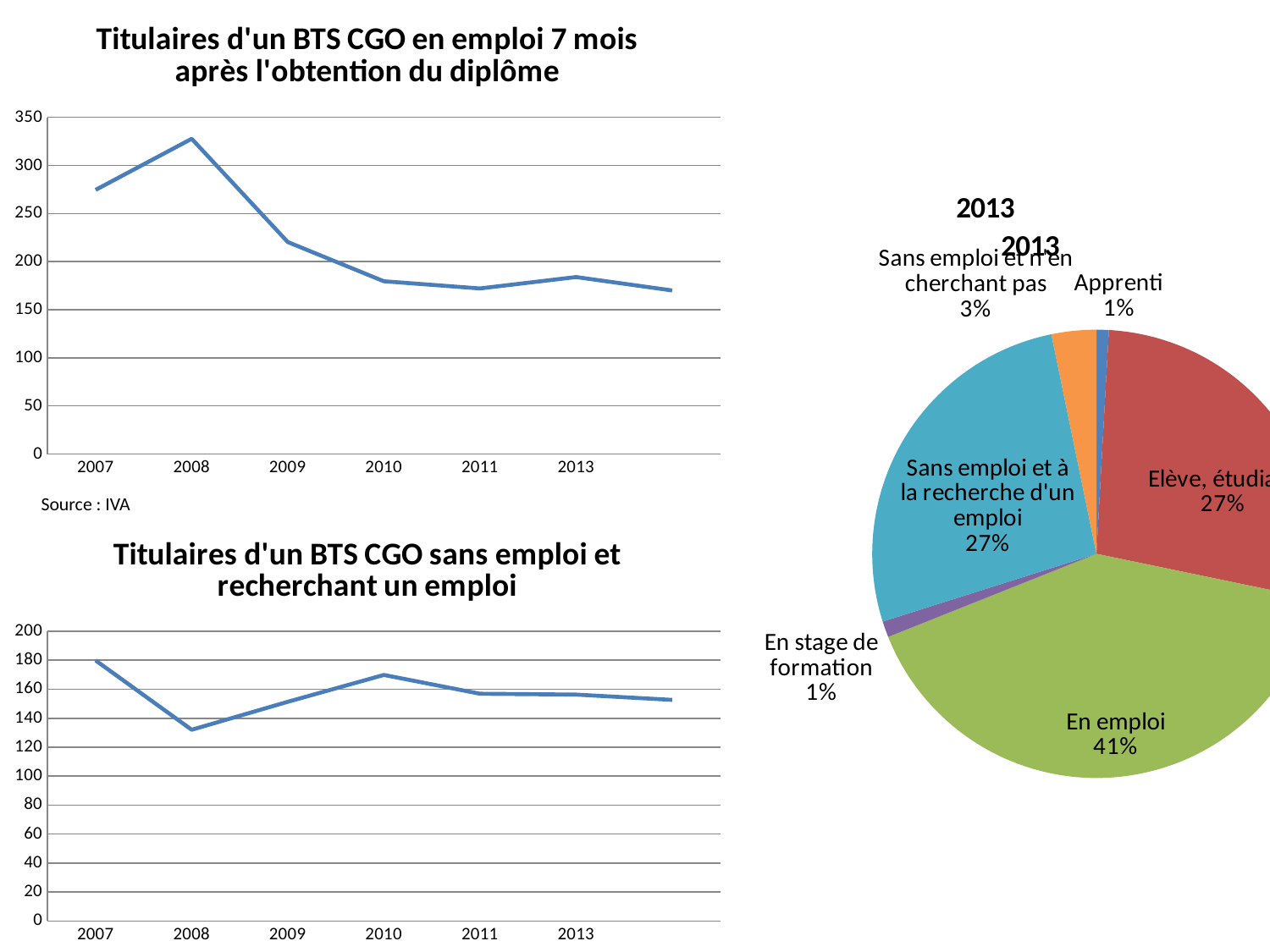
In the pie chart titled 2013, which category has the largest slice? En emploi In the chart titled 'Titulaires d'un BTS CGO en emploi 7 mois après l'obtention du diplôme', which year has the highest value? 2008 In the pie chart titled 2013, how many percentage points larger is the En emploi slice than the Elève, étudiant slice? 14 What kind of chart is the chart titled 2013 on the right of the slide? Pie chart In the chart titled 'Titulaires d'un BTS CGO en emploi 7 mois après l'obtention du diplôme', is the value for 2008 greater or less than 300? greater What kind of chart is the chart titled 'Titulaires d'un BTS CGO sans emploi et recherchant un emploi'? Line chart In the chart titled 'Titulaires d'un BTS CGO en emploi 7 mois après l'obtention du diplôme', is the value for 2010 greater or less than 200? less In the pie chart titled 2013, what share is labelled for Sans emploi et n'en cherchant pas? 3% In the pie chart titled 2013, what share is labelled for En emploi? 41% In the chart titled 'Titulaires d'un BTS CGO sans emploi et recherchant un emploi', which year has the lowest value? 2008 In the pie chart titled 2013, how many slices are there? 6 In the pie chart titled 2013, what share is labelled for Apprenti? 1%